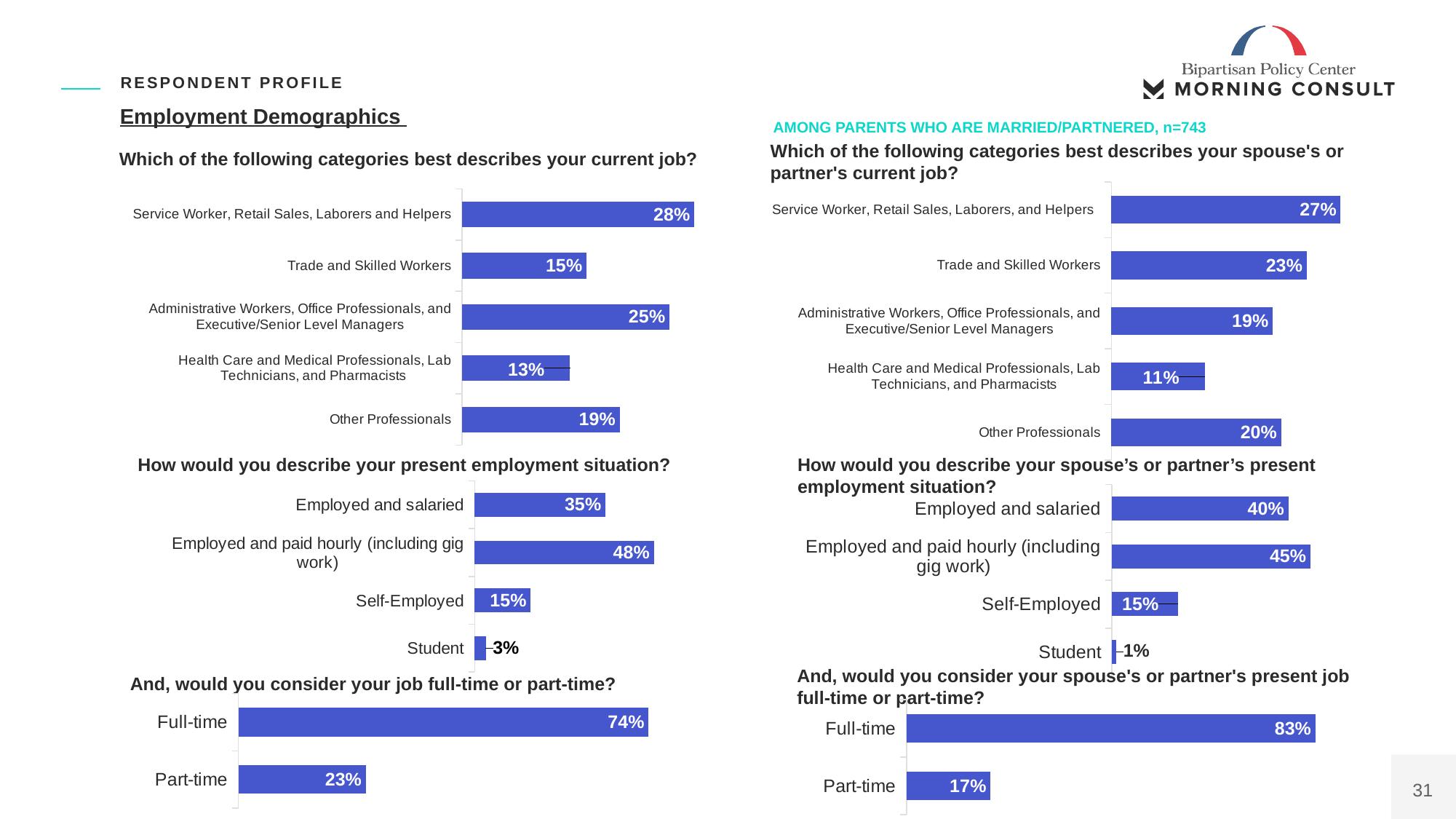
In the chart titled "And, would you consider your spouse's or partner's present job full-time or part-time?", what is the difference between Full-time and Part-time? 66% In the chart titled "How would you describe your present employment situation?", how many categories are shown? 4 In the chart titled "Which of the following categories best describes your current job?", what is the value for Trade and Skilled Workers? 15% What kind of chart is the chart titled "And, would you consider your job full-time or part-time?"? Bar chart In the chart titled "How would you describe your spouse's or partner's present employment situation?", what is the value for Student? 1% In the chart titled "Which of the following categories best describes your current job?", which category has the highest value? Service Worker, Retail Sales, Laborers and Helpers In the chart titled "Which of the following categories best describes your spouse's or partner's current job?", what is the value for Other Professionals? 20% In the chart titled "How would you describe your present employment situation?", what is the difference between Employed and paid hourly (including gig work) and Employed and salaried? 13% In the chart titled "Which of the following categories best describes your current job?", how many categories are shown? 5 In the chart titled "Which of the following categories best describes your spouse's or partner's current job?", which category has the lowest value? Health Care and Medical Professionals, Lab Technicians, and Pharmacists In the chart titled "How would you describe your spouse's or partner's present employment situation?", which is larger: Employed and salaried or Employed and paid hourly (including gig work)? Employed and paid hourly (including gig work) In the chart titled "And, would you consider your job full-time or part-time?", what is the value for Part-time? 23%